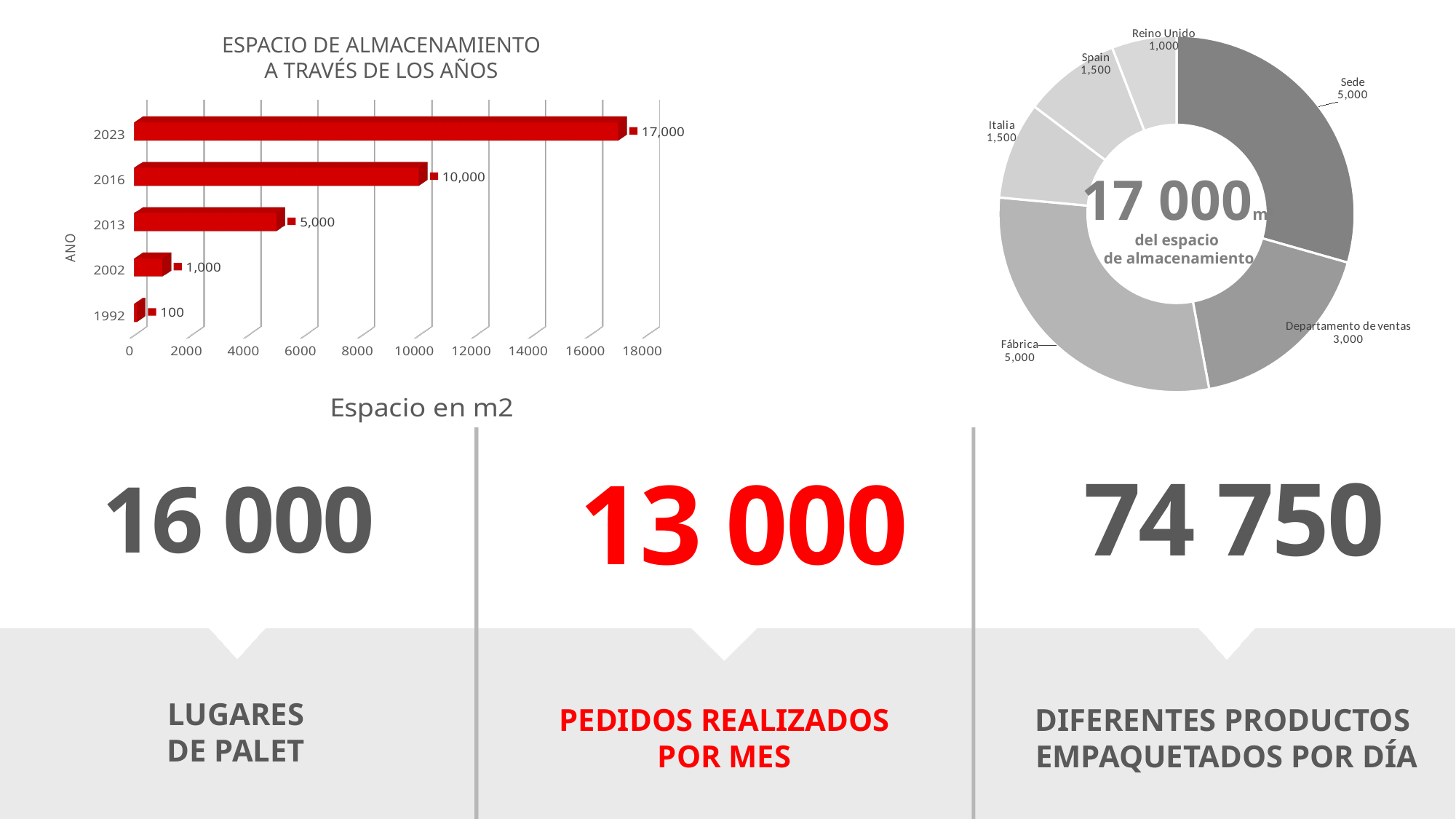
In the bar chart 'ESPACIO DE ALMACENAMIENTO A TRAVÉS DE LOS AÑOS', what is the value for 1992? 100 In the doughnut chart on the right, what is the value for Reino Unido? 1,000 In the bar chart 'ESPACIO DE ALMACENAMIENTO A TRAVÉS DE LOS AÑOS', how many years are shown? 5 In the doughnut chart on the right, which category has the lowest value? Reino Unido In the doughnut chart on the right, what is the value for Departamento de ventas? 3,000 In the bar chart 'ESPACIO DE ALMACENAMIENTO A TRAVÉS DE LOS AÑOS', what is the difference between the values for 2023 and 2016? 7,000 In the doughnut chart on the right, which is larger, Sede or Departamento de ventas? Sede In the bar chart 'ESPACIO DE ALMACENAMIENTO A TRAVÉS DE LOS AÑOS', do the values rise or fall from 1992 to 2023? rise In the bar chart 'ESPACIO DE ALMACENAMIENTO A TRAVÉS DE LOS AÑOS', which year has the highest value? 2023 In the doughnut chart on the right, how many categories are shown? 6 What kind of chart is the chart on the left of the slide? bar chart In the bar chart 'ESPACIO DE ALMACENAMIENTO A TRAVÉS DE LOS AÑOS', what is the value for 2016? 10,000